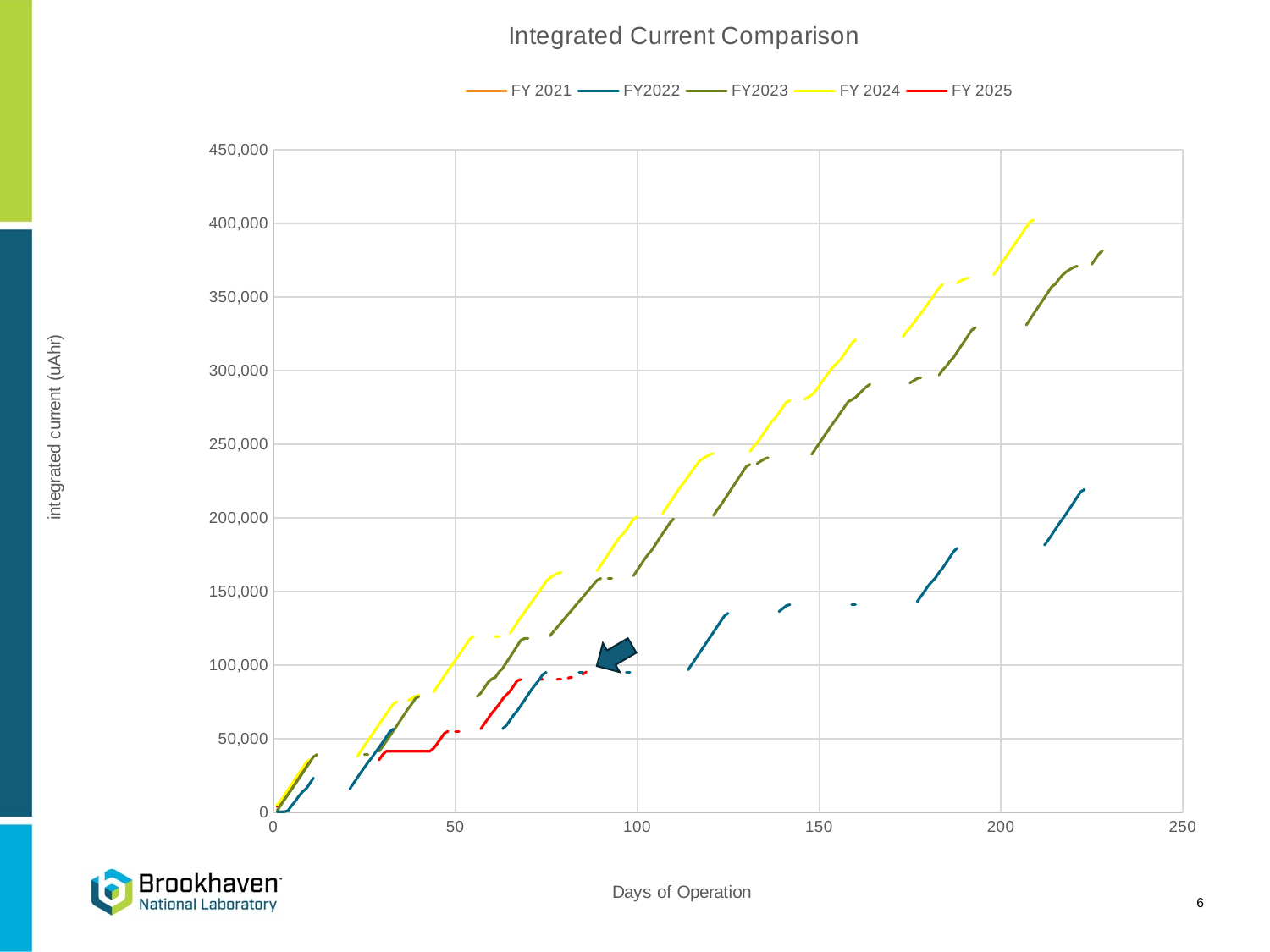
Is the value for FY 2024 at 200 days of operation greater or less than 350,000? greater At 100 days of operation, which series has the lowest integrated current? FY2022 Is the value for FY2022 at 100 days of operation greater or less than 100,000? less How many series does the legend list? 5 Is the value for FY2023 at 100 days of operation greater or less than 150,000? greater At 100 days of operation, which is larger: the value for FY 2024 or the value for FY2022? FY 2024 What is the title of the chart? Integrated Current Comparison Do the integrated current values rise or fall as days of operation increase? rise What is the label of the y axis? integrated current (uAhr) What kind of chart is shown on the slide? line chart Which series reaches the highest integrated current on the chart? FY 2024